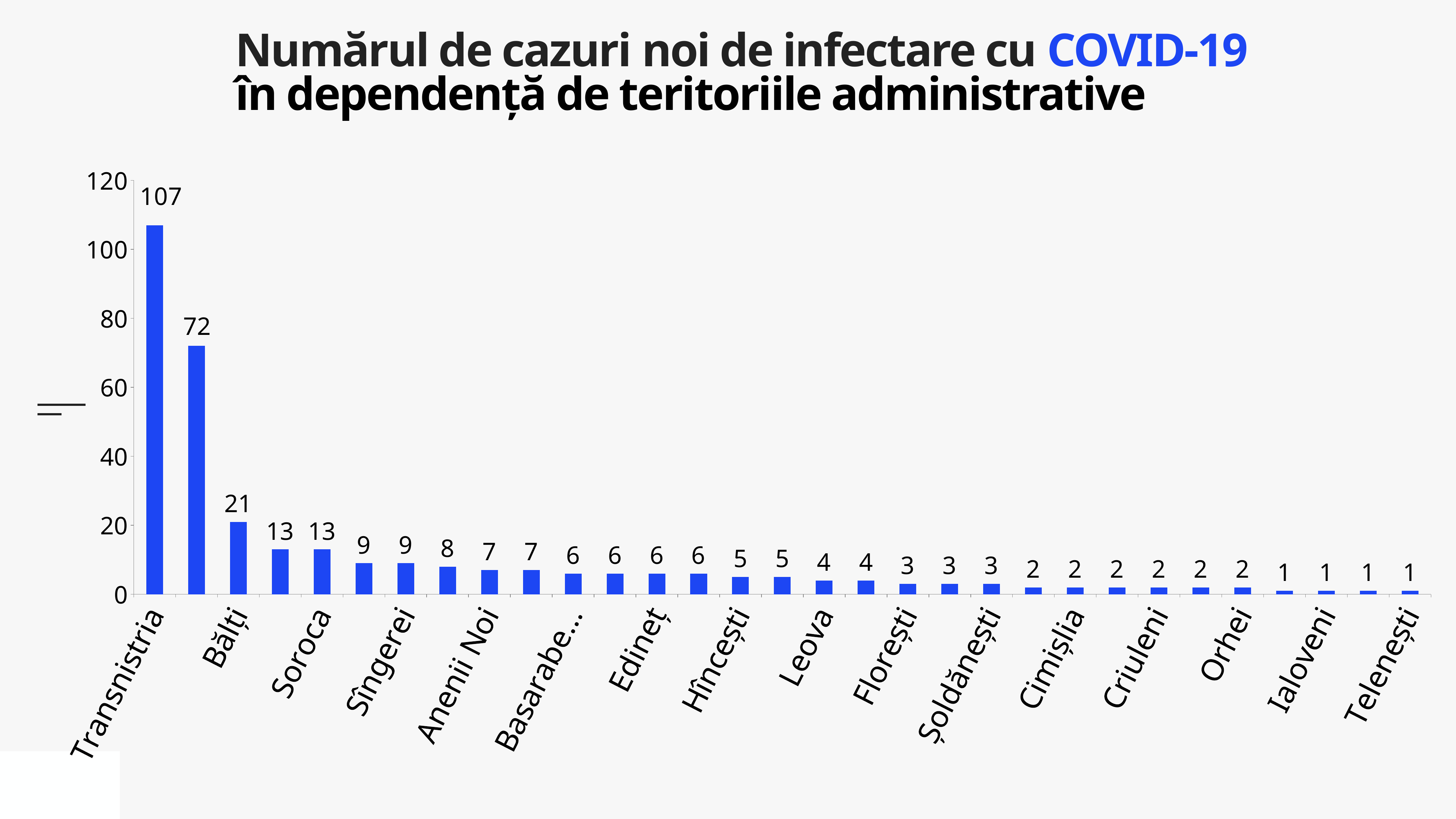
Which has a larger value, Transnistria or Soroca? Transnistria Is the value for Transnistria greater or less than 100? greater What is the lowest value shown on the chart? 1 What is the value for Leova? 4 What is the difference between the highest bar (107) and the second highest bar (72)? 35 How many bars are plotted on the chart? 31 Which territory has the highest number of new cases? Transnistria What type of chart is shown on the slide? bar chart What is the value for Transnistria? 107 Do the values rise or fall from left to right along the x axis? fall What is the value for Soroca? 13 What is the value for Telenești? 1